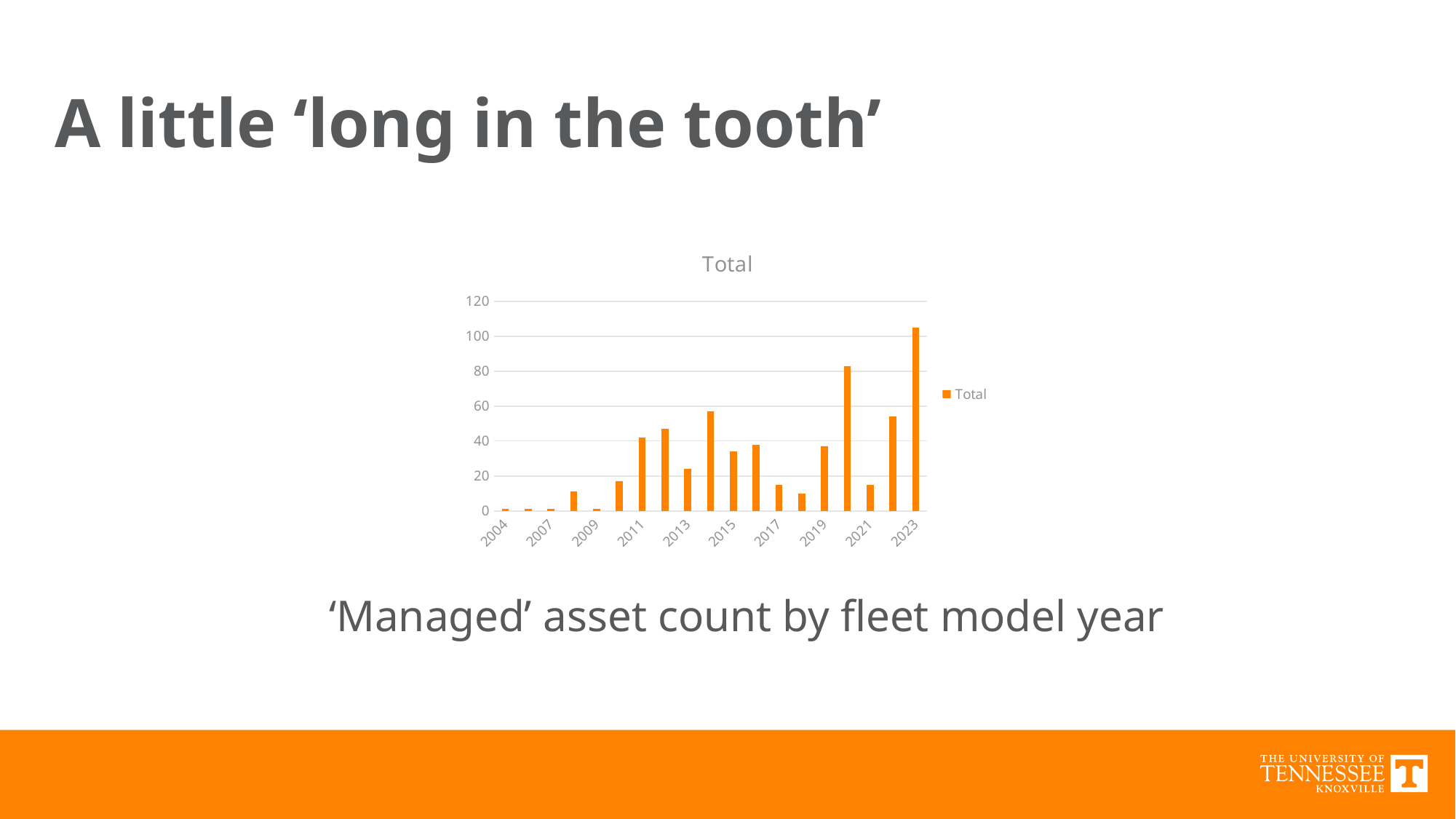
Is the value for 2019 greater or less than 40? less What colour are the bars in the chart? orange Is the value for 2021 greater or less than 20? less What kind of chart is shown on the slide? bar chart How many series does the legend list? 1 Is the value for 2013 greater or less than 20? greater Which year has the highest value in the chart? 2023 Which is larger, the value for 2011 or the value for 2013? 2011 What is the title of the chart? Total Which is larger, the value for 2015 or the value for 2017? 2015